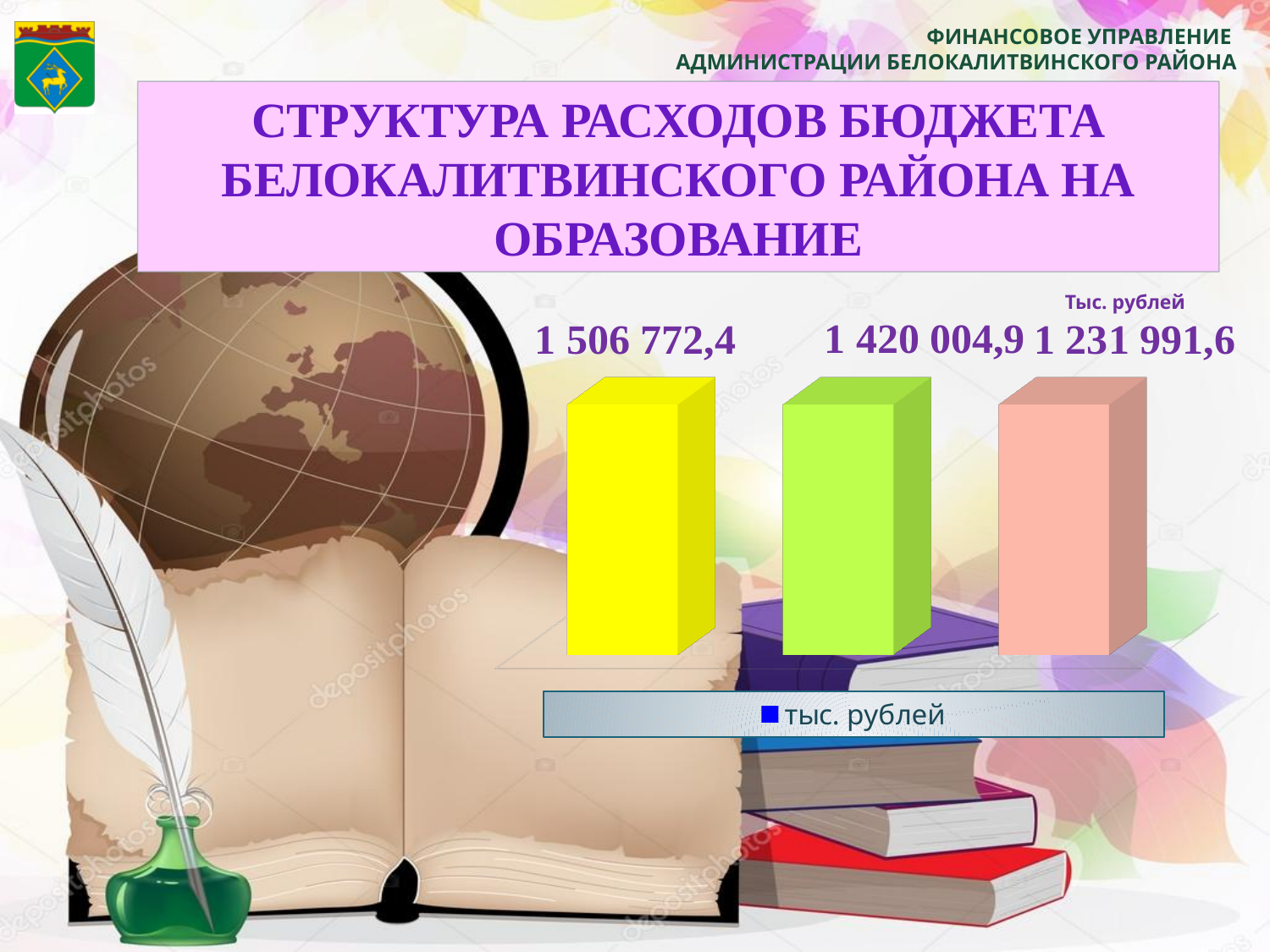
What value is shown above the middle (green) bar? 1 420 004,9 How many bars are plotted in the chart? 3 Which bar has the highest value? The leftmost (yellow) bar, 1 506 772,4 Do the values rise or fall from left to right across the bars? Fall How many series does the legend list? 1 What kind of chart is shown on the slide? Bar chart What is the difference between the leftmost bar and the middle bar? 86 767,5 Which is larger, the value of the middle bar or the rightmost bar? The middle bar (1 420 004,9) What value is shown above the rightmost (pink) bar? 1 231 991,6 Which bar has the lowest value? The rightmost (pink) bar, 1 231 991,6 What is the difference between the middle bar and the rightmost bar? 188 013,3 What value is shown above the leftmost (yellow) bar? 1 506 772,4